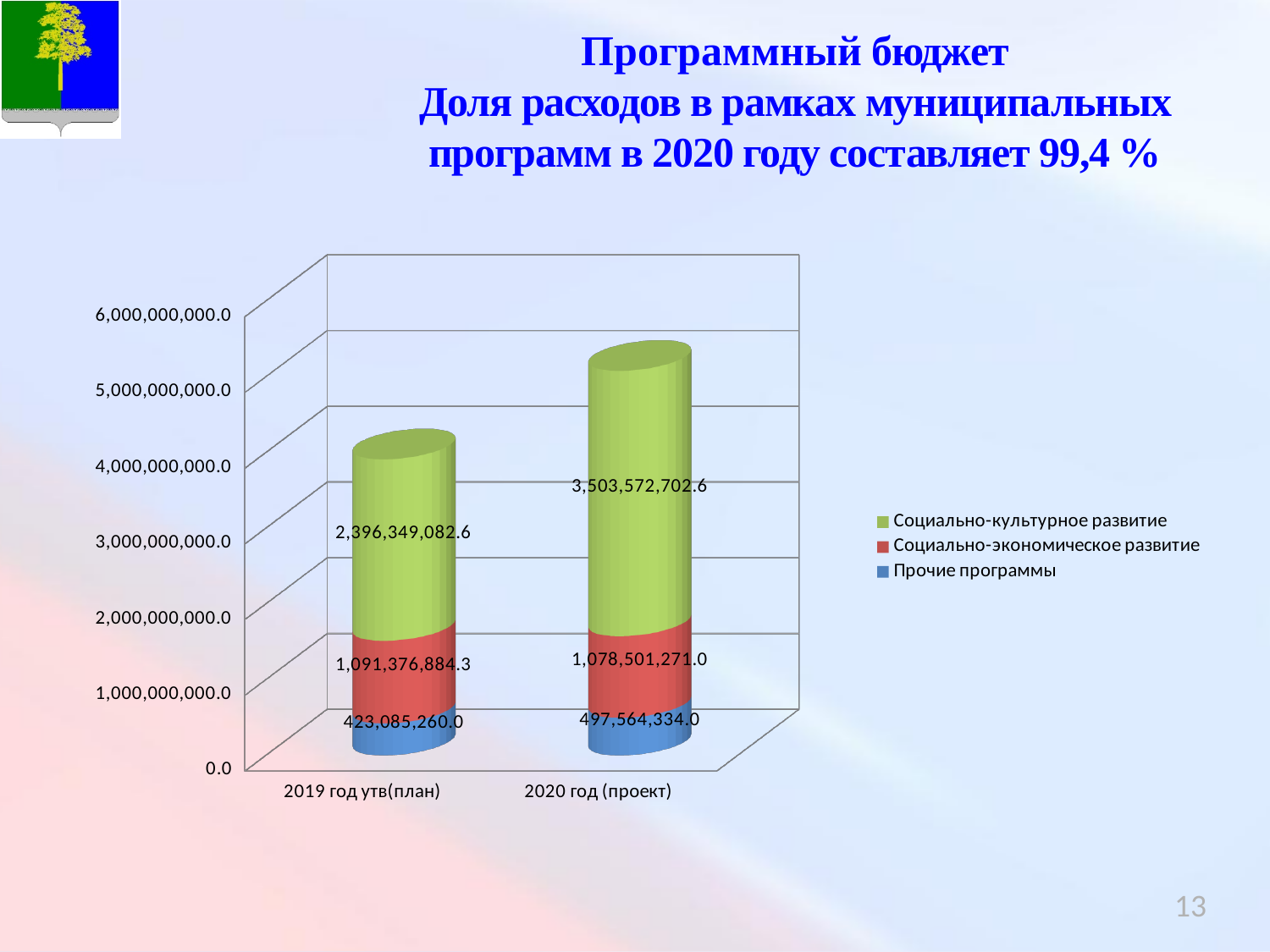
What is the value of Прочие программы for 2020 год (проект)? 497,564,334.0 How many categories are shown on the x axis? 2 What is the value of Социально-экономическое развитие for 2019 год утв(план)? 1,091,376,884.3 Which category has the lower value for Прочие программы? 2019 год утв(план) What type of chart is shown on the slide? Stacked bar chart How many series does the legend list? 3 What is the total of the stacked bar for 2020 год (проект)? 5,079,638,307.6 Which series is shown in green in the legend? Социально-культурное развитие What is the value of Социально-культурное развитие for 2020 год (проект)? 3,503,572,702.6 What is the difference between the Социально-культурное развитие values for 2020 год (проект) and 2019 год утв(план)? 1,107,223,620.0 What is the value of Прочие программы for 2019 год утв(план)? 423,085,260.0 Which category has the higher value for Социально-культурное развитие? 2020 год (проект)